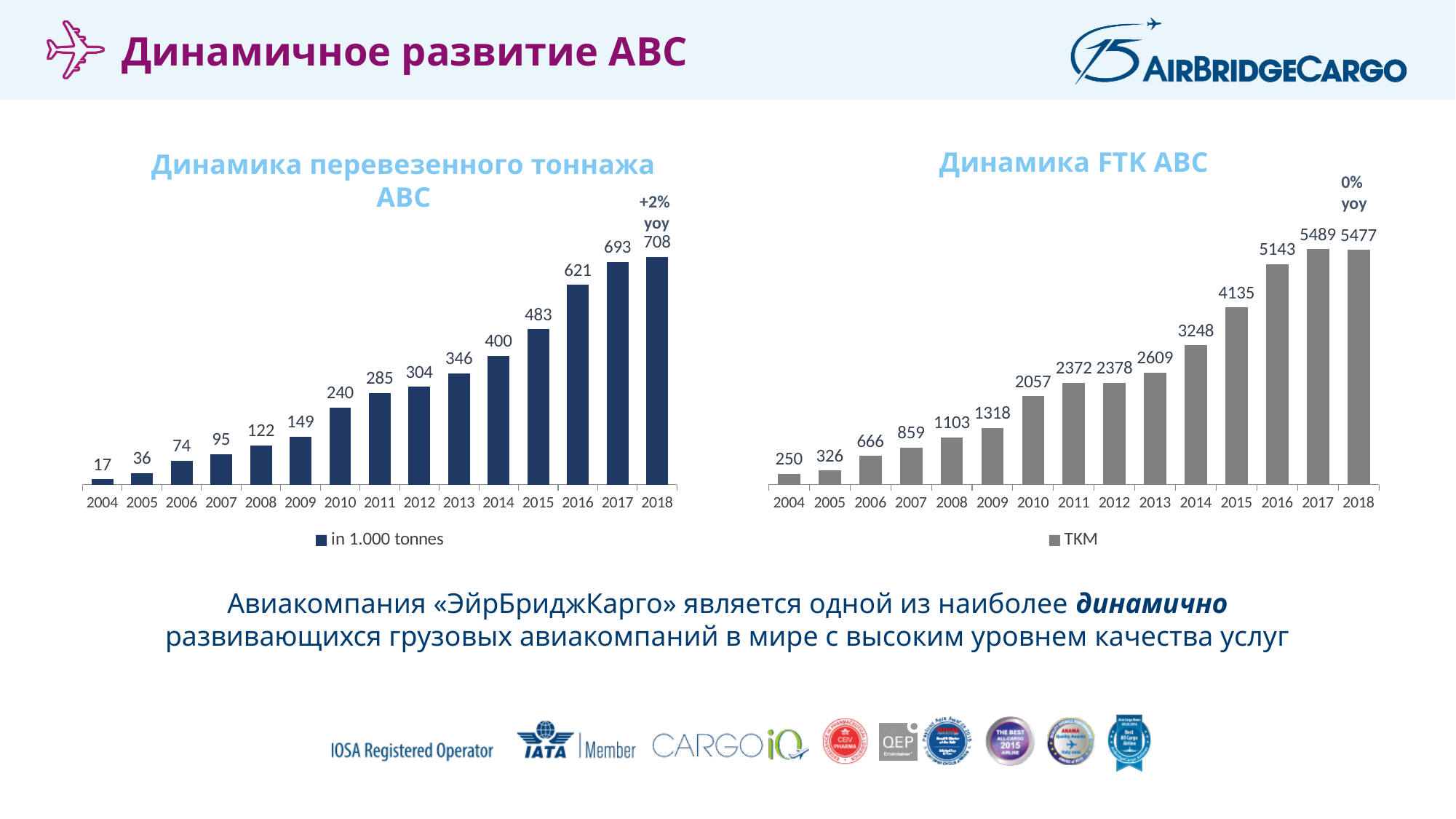
What is the legend entry of the chart titled 'Динамика перевезенного тоннажа ABC'? in 1.000 tonnes How many years are shown on the x axis of the chart titled 'Динамика перевезенного тоннажа ABC'? 15 How many series does the legend of the chart titled 'Динамика FTK ABC' list? 1 In the chart titled 'Динамика FTK ABC', what is the difference between the values for 2016 and 2015? 1008 In the chart titled 'Динамика FTK ABC', which is larger: the value for 2017 or the value for 2018? 2017 In the chart titled 'Динамика перевезенного тоннажа ABC', do the values rise or fall from 2004 to 2018? Rise What kind of chart is the chart titled 'Динамика перевезенного тоннажа ABC'? Bar chart In the chart titled 'Динамика перевезенного тоннажа ABC', which year has the lowest value? 2004 In the chart titled 'Динамика перевезенного тоннажа ABC', what is the value for 2010? 240 In the chart titled 'Динамика FTK ABC', what is the value for 2014? 3248 In the chart titled 'Динамика FTK ABC', which year has the highest value? 2017 In the chart titled 'Динамика перевезенного тоннажа ABC', what is the difference between the values for 2018 and 2017? 15